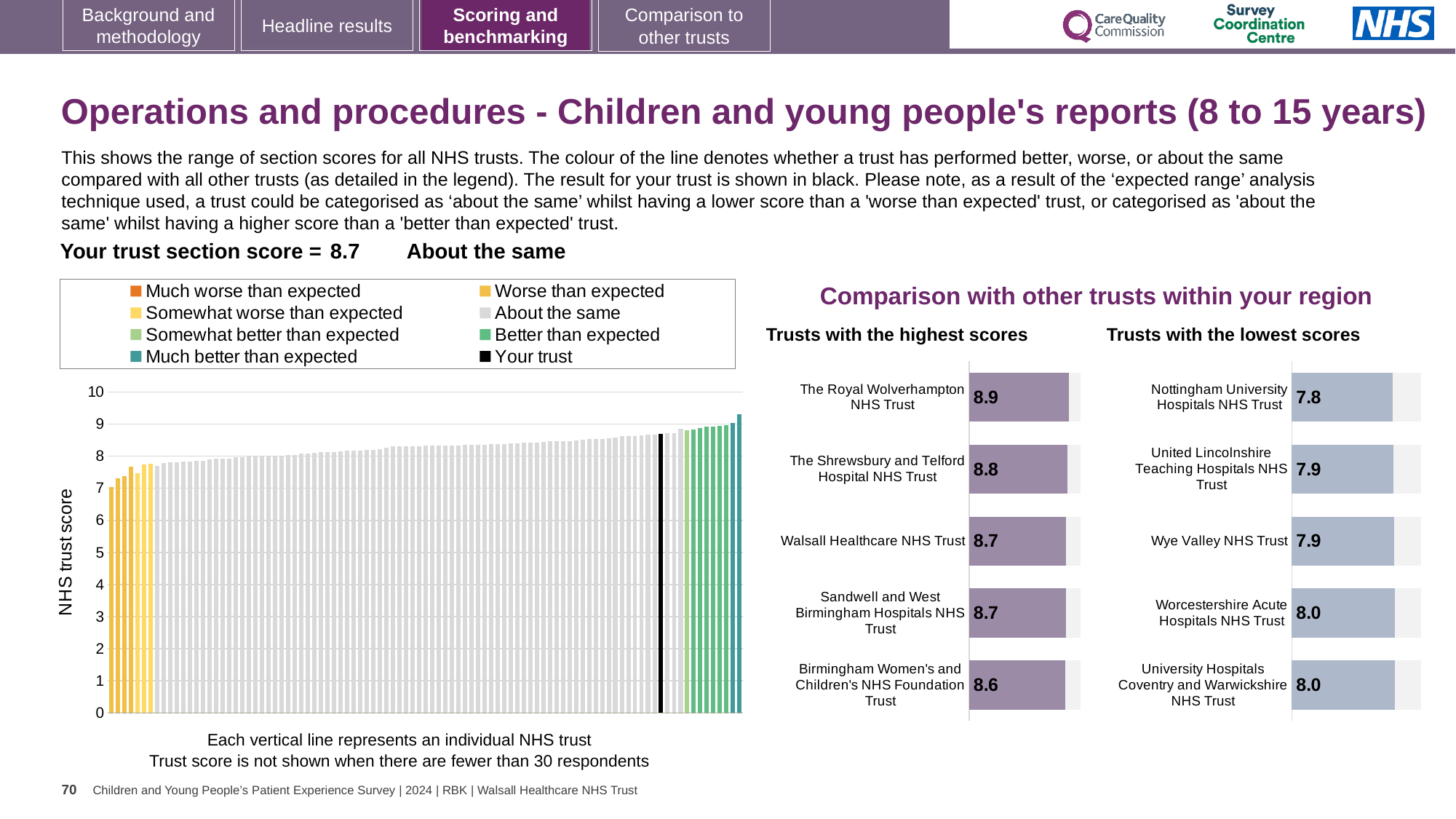
In the large chart on the left, is the value for the black 'Your trust' bar greater or less than 8? greater In the 'Trusts with the highest scores' chart, what is the score for Birmingham Women's and Children's NHS Foundation Trust? 8.6 In the 'Trusts with the lowest scores' chart, which has the larger score: Nottingham University Hospitals NHS Trust or Worcestershire Acute Hospitals NHS Trust? Worcestershire Acute Hospitals NHS Trust In the 'Trusts with the lowest scores' chart, which trust has the lowest score? Nottingham University Hospitals NHS Trust In the 'Trusts with the highest scores' chart, how many trusts are shown? 5 What kind of chart is the large chart on the left showing NHS trust scores? Bar chart In the 'Trusts with the lowest scores' chart, what is the difference between the scores of Worcestershire Acute Hospitals NHS Trust and Nottingham University Hospitals NHS Trust? 0.2 In the 'Trusts with the lowest scores' chart, what is the score for Nottingham University Hospitals NHS Trust? 7.8 In the 'Trusts with the highest scores' chart, which trust has the highest score? The Royal Wolverhampton NHS Trust In the 'Trusts with the highest scores' chart, what is the score for The Royal Wolverhampton NHS Trust? 8.9 In the 'Trusts with the highest scores' chart, what is the difference between the scores of The Royal Wolverhampton NHS Trust and Birmingham Women's and Children's NHS Foundation Trust? 0.3 How many entries does the legend of the large chart on the left list? 8